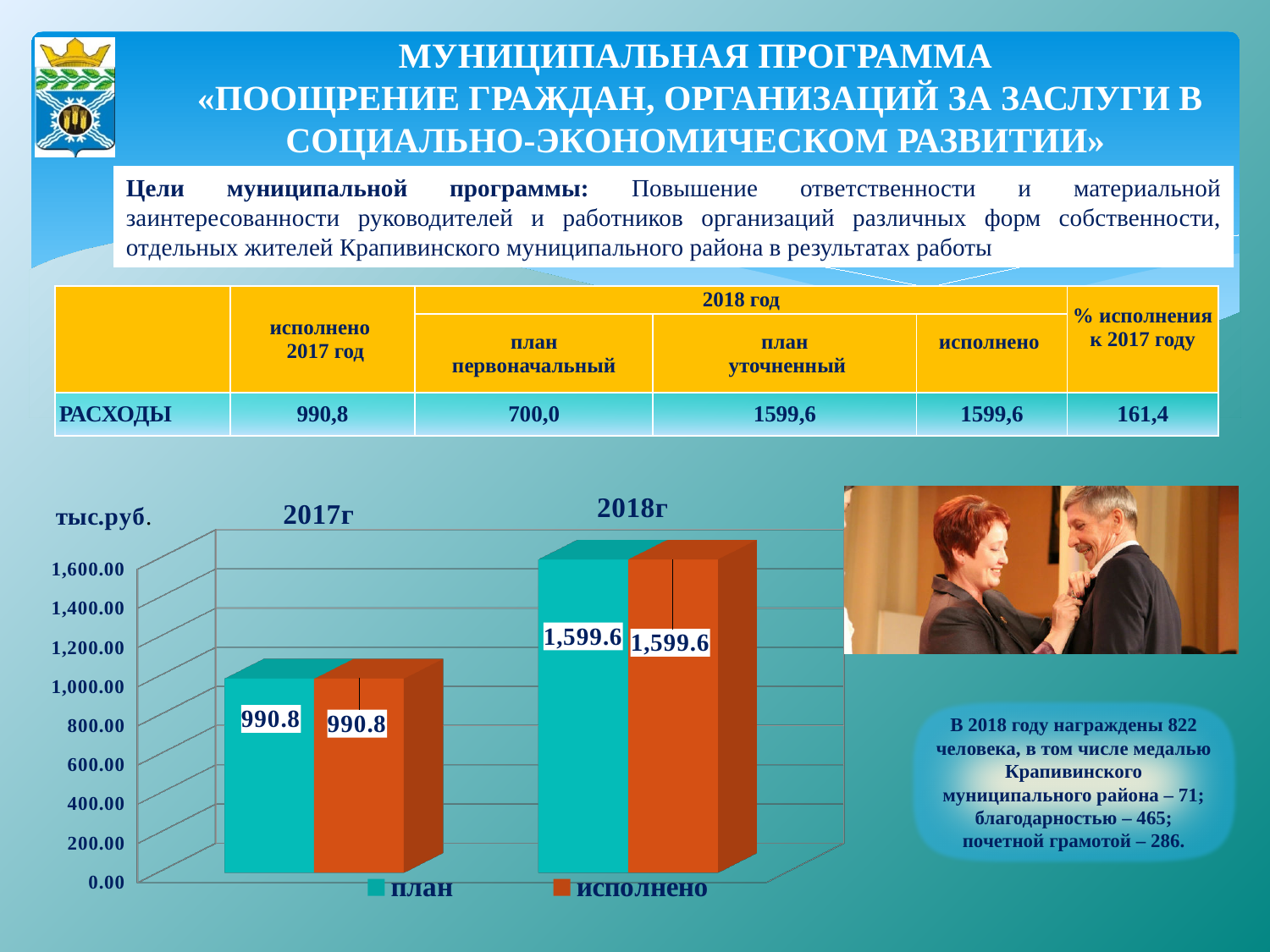
What is the difference between the план values for 2018г and 2017г? 608.8 What is the value of the план bar for 2018г? 1,599.6 What is the value of the исполнено bar for 2017г? 990.8 Is the исполнено value for 2017г greater or less than 1,000.00? less Do the план values rise or fall from 2017г to 2018г? rise Which year has the higher исполнено value, 2017г or 2018г? 2018г What type of chart is shown on the slide? bar chart How many series does the chart legend list? 2 How many year categories are shown on the x axis of the chart? 2 What unit is shown at the top of the chart's vertical axis? тыс.руб. What is the value of the план bar for 2017г? 990.8 What is the value of the исполнено bar for 2018г? 1,599.6